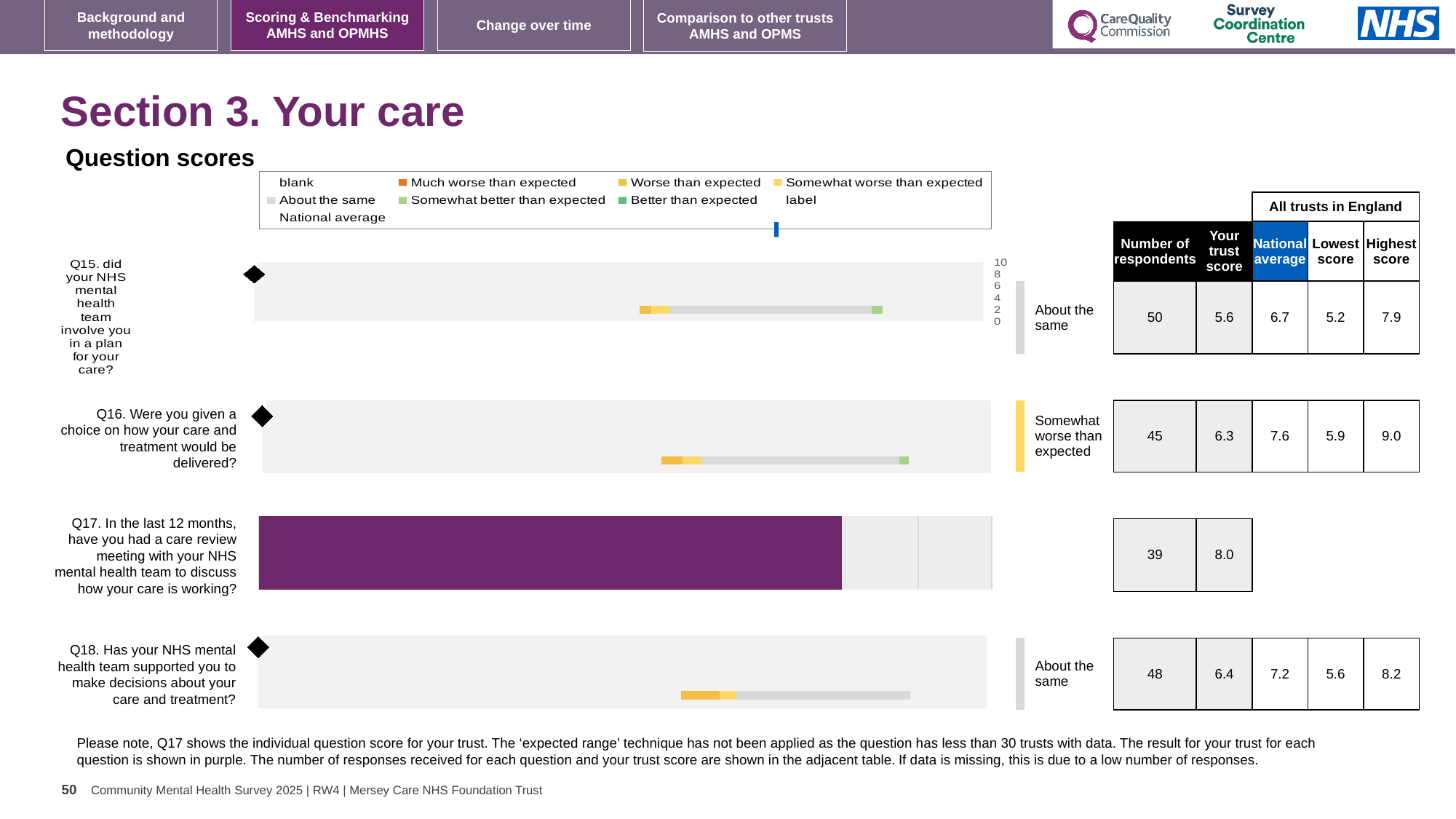
What is the trust score for Q15 (did your NHS mental health team involve you in a plan for your care)? 5.6 What is the national average for Q18 (has your NHS mental health team supported you to make decisions about your care and treatment)? 7.2 Which question has the lowest trust score? Q15 What is the difference between the highest score and the lowest score for Q15? 2.7 How many questions are plotted in the Question scores chart? 4 What benchmark label is shown next to the bar for Q16? Somewhat worse than expected What is the difference between the national average and the trust score for Q16? 1.3 What kind of chart is used to show the question scores? Bar chart Which has the larger trust score, Q18 or Q16? Q18 What is the highest score among all trusts in England for Q16? 9.0 How many respondents answered Q16 (were you given a choice on how your care and treatment would be delivered)? 45 Which question has the highest trust score? Q17